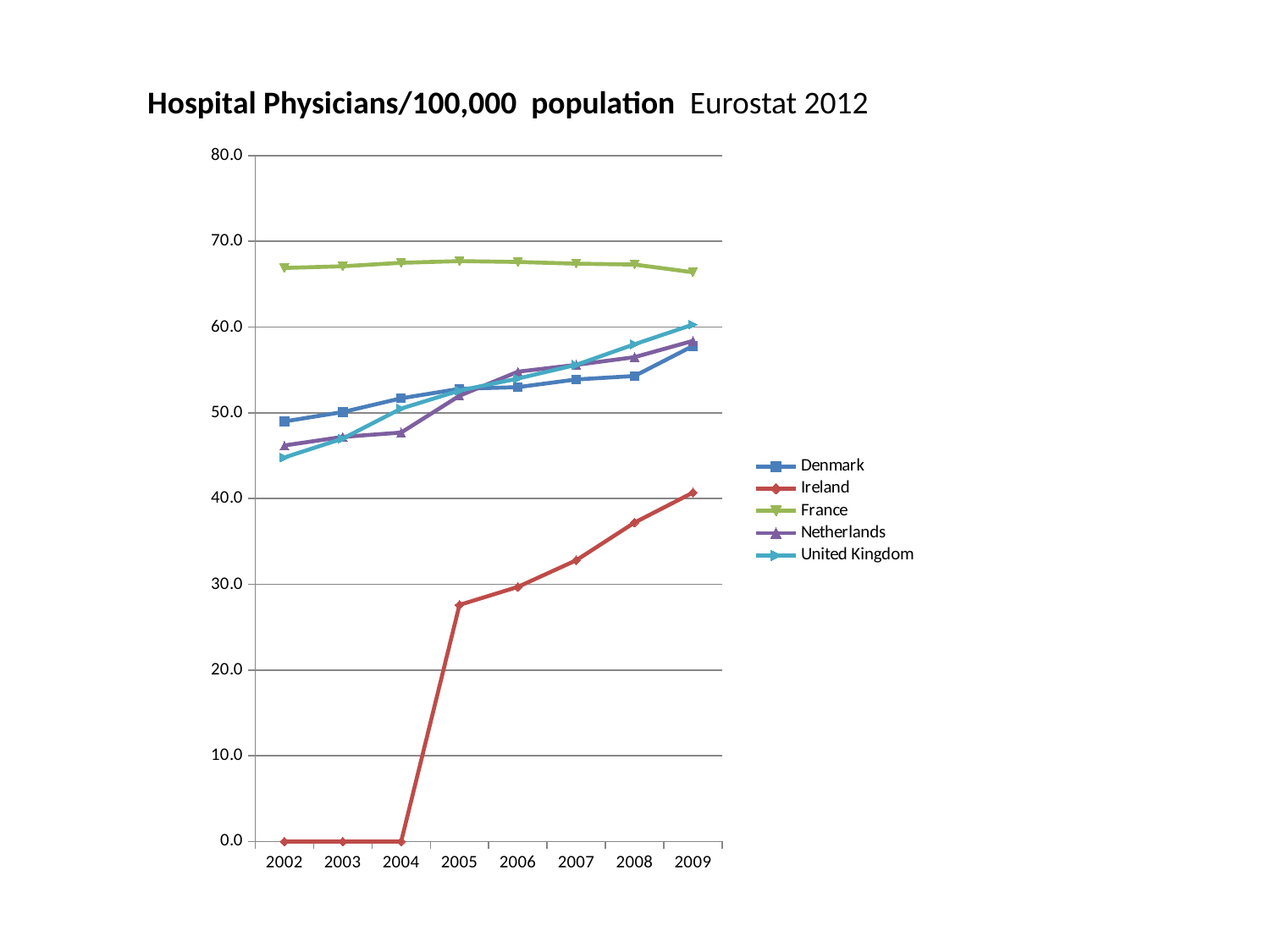
Is the value for France in 2005 greater or less than 60.0? greater Does the value for Ireland rise or fall from 2005 to 2009? rise How many series does the legend list? 5 Which country has the highest value in 2009? France Which country has the lowest value in 2009? Ireland Is the value for the United Kingdom in 2002 greater or less than 50.0? less Is the value for Ireland in 2009 greater or less than 50.0? less What is the value for Ireland in 2002? 0.0 What is the title of the chart? Hospital Physicians/100,000 population Eurostat 2012 Which is larger in 2002, the value for Denmark or the value for the United Kingdom? Denmark What kind of chart is shown on the slide? line chart How many years are shown on the x axis? 8